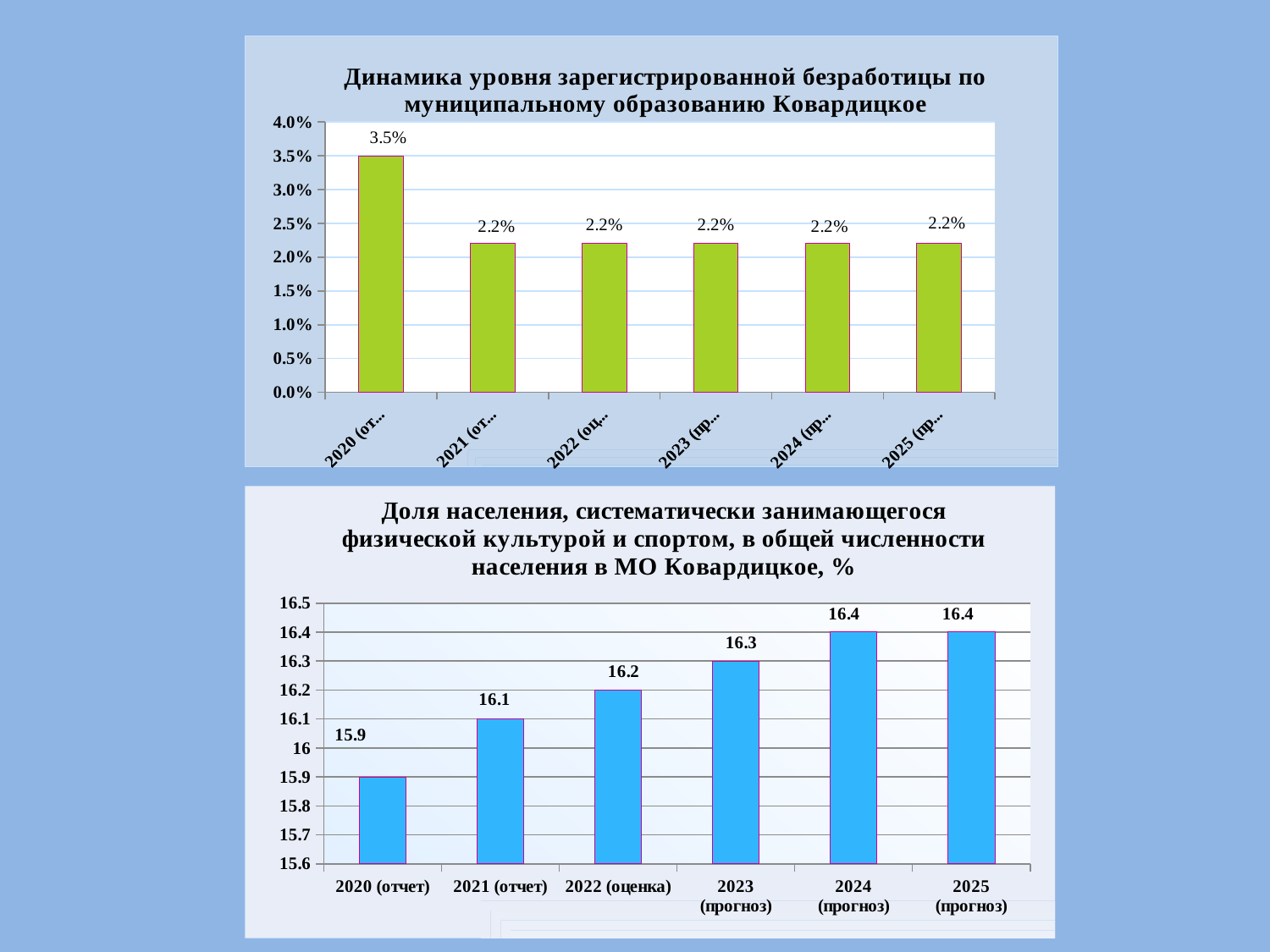
What kind of chart is the top chart (registered unemployment rate)? bar chart In the top chart (registered unemployment rate), which year has the highest value? 2020 How many bars are plotted in the top chart (registered unemployment rate)? 6 In the bottom chart (share of population engaged in physical culture and sport), what is the value for 2020 (отчет)? 15.9 In the bottom chart (share of population engaged in physical culture and sport), which year has the lowest value? 2020 (отчет) In the top chart (registered unemployment rate), what is the difference between the 2020 value and the 2021 value? 1.3% In the top chart (registered unemployment rate), what is the value for 2020? 3.5% In the bottom chart (share of population engaged in physical culture and sport), what is the value for 2023 (прогноз)? 16.3 In the top chart (registered unemployment rate), what is the value for 2023? 2.2% In the bottom chart (share of population engaged in physical culture and sport), which is larger: the value for 2021 (отчет) or the value for 2022 (оценка)? 2022 (оценка) In the bottom chart (share of population engaged in physical culture and sport), what is the difference between the 2025 (прогноз) value and the 2020 (отчет) value? 0.5 In the bottom chart (share of population engaged in physical culture and sport), do the values rise or fall from 2020 to 2025? rise